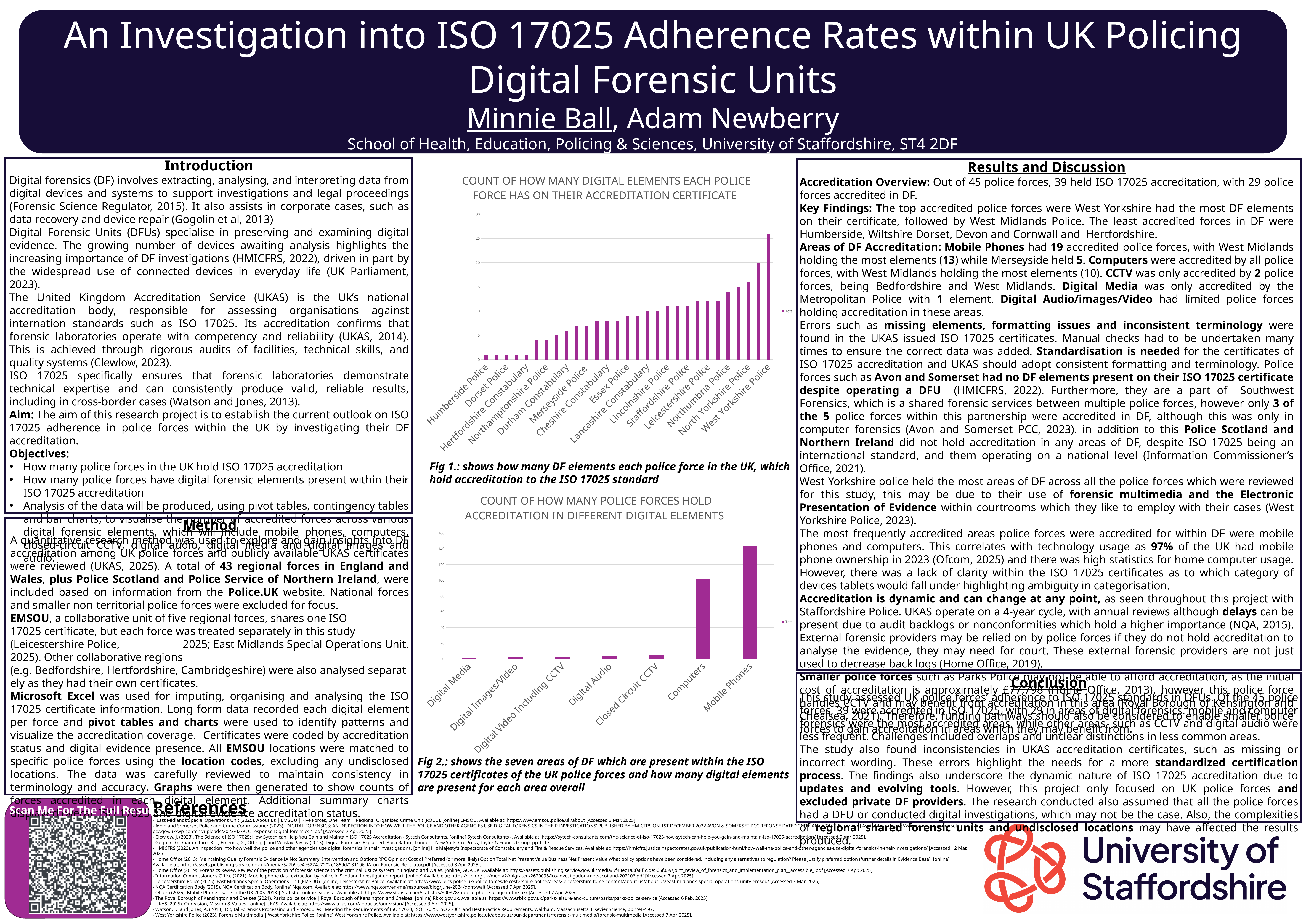
In the chart titled 'COUNT OF HOW MANY DIGITAL ELEMENTS EACH POLICE FORCE HAS ON THEIR ACCREDITATION CERTIFICATE', do the values generally rise or fall from left to right along the x axis? rise How many series does the legend of the chart titled 'COUNT OF HOW MANY POLICE FORCES HOLD ACCREDITATION IN DIFFERENT DIGITAL ELEMENTS' list? 1 In the chart titled 'COUNT OF HOW MANY DIGITAL ELEMENTS EACH POLICE FORCE HAS ON THEIR ACCREDITATION CERTIFICATE', which police force has the highest value? West Yorkshire Police In the chart titled 'COUNT OF HOW MANY POLICE FORCES HOLD ACCREDITATION IN DIFFERENT DIGITAL ELEMENTS', which digital element has the highest value? Mobile Phones In the chart titled 'COUNT OF HOW MANY POLICE FORCES HOLD ACCREDITATION IN DIFFERENT DIGITAL ELEMENTS', which is larger, the value for Computers or the value for Mobile Phones? Mobile Phones What kind of chart is the top chart on the slide? bar chart In the chart titled 'COUNT OF HOW MANY POLICE FORCES HOLD ACCREDITATION IN DIFFERENT DIGITAL ELEMENTS', how many digital element categories are shown on the x axis? 7 In the chart titled 'COUNT OF HOW MANY POLICE FORCES HOLD ACCREDITATION IN DIFFERENT DIGITAL ELEMENTS', is the value for Computers greater or less than 120? less In the chart titled 'COUNT OF HOW MANY DIGITAL ELEMENTS EACH POLICE FORCE HAS ON THEIR ACCREDITATION CERTIFICATE', is the value for West Yorkshire Police greater or less than 20? greater In the chart titled 'COUNT OF HOW MANY DIGITAL ELEMENTS EACH POLICE FORCE HAS ON THEIR ACCREDITATION CERTIFICATE', which is larger, the value for Merseyside Police or the value for Leicestershire Police? Leicestershire Police In the chart titled 'COUNT OF HOW MANY DIGITAL ELEMENTS EACH POLICE FORCE HAS ON THEIR ACCREDITATION CERTIFICATE', is the value for Humberside Police greater or less than 5? less